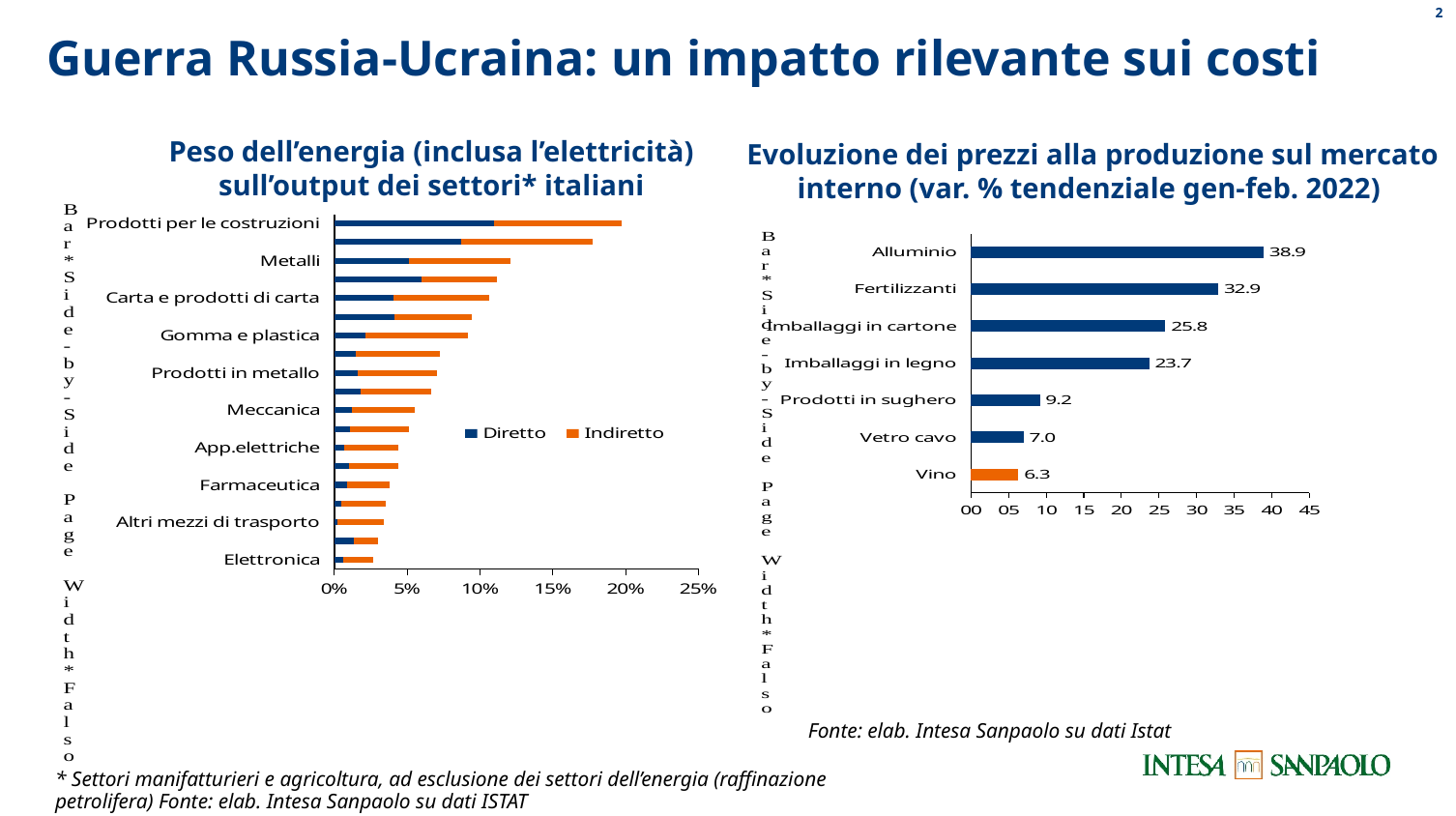
How many series does the legend list in the chart 'Peso dell'energia (inclusa l'elettricità) sull'output dei settori* italiani'? 2 In the chart 'Evoluzione dei prezzi alla produzione sul mercato interno', which is larger: Prodotti in sughero or Vetro cavo? Prodotti in sughero In the chart 'Evoluzione dei prezzi alla produzione sul mercato interno', what is the difference between the values for Fertilizzanti and Imballaggi in cartone? 7.1 What are the two series named in the legend of the chart 'Peso dell'energia (inclusa l'elettricità) sull'output dei settori* italiani'? Diretto and Indiretto In the chart 'Evoluzione dei prezzi alla produzione sul mercato interno', what is the value for Alluminio? 38.9 In the chart 'Evoluzione dei prezzi alla produzione sul mercato interno', what is the value for Imballaggi in legno? 23.7 In the chart 'Evoluzione dei prezzi alla produzione sul mercato interno', which category has the highest value? Alluminio In the chart 'Peso dell'energia (inclusa l'elettricità) sull'output dei settori* italiani', is the total value for Prodotti per le costruzioni greater or less than 15%? greater How many categories are shown in the chart 'Evoluzione dei prezzi alla produzione sul mercato interno'? 7 In the chart 'Evoluzione dei prezzi alla produzione sul mercato interno', what is the value for Vetro cavo? 7.0 In the chart 'Evoluzione dei prezzi alla produzione sul mercato interno', which category has the lowest value? Vino What kind of chart is 'Evoluzione dei prezzi alla produzione sul mercato interno'? Bar chart